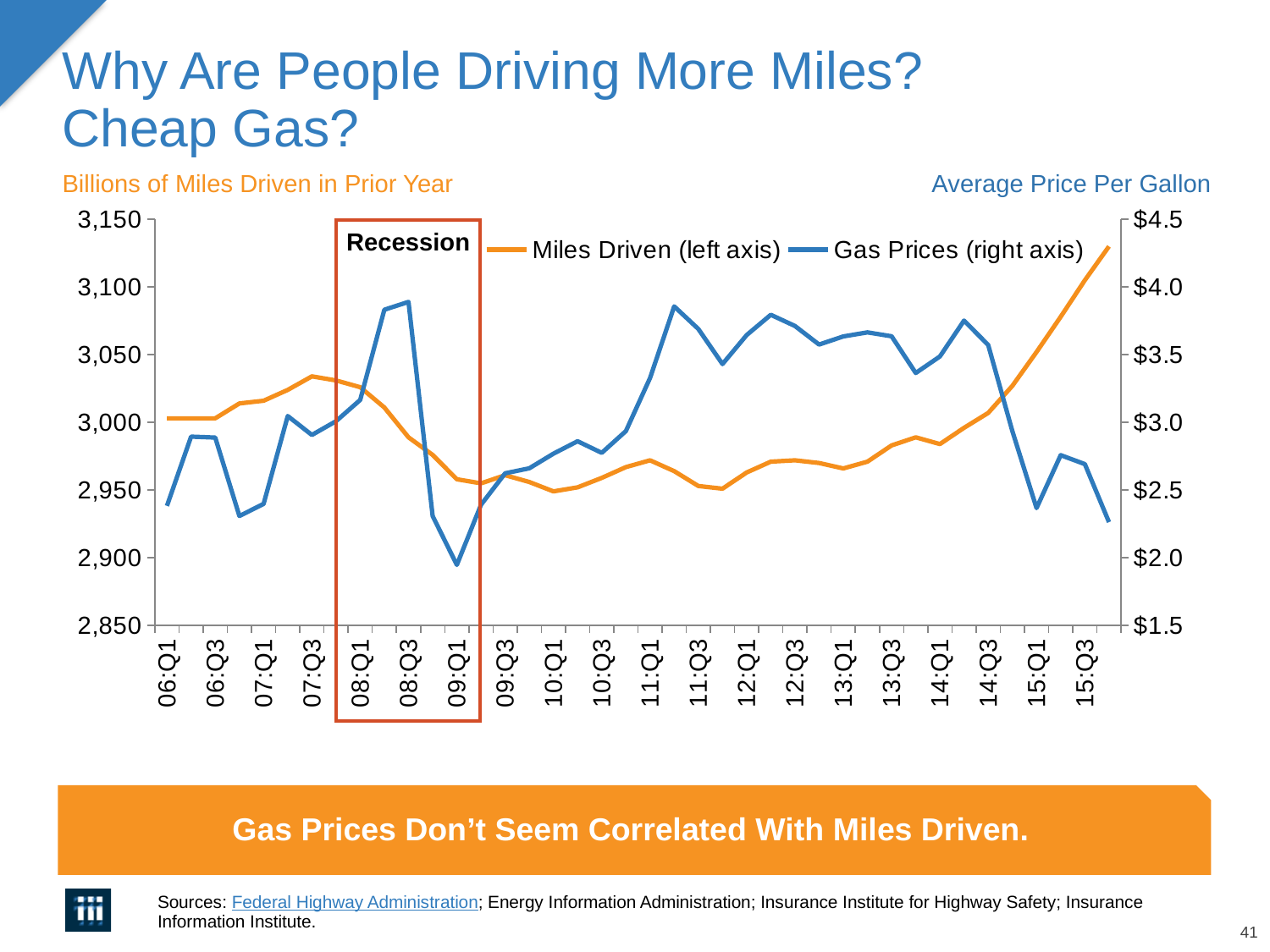
At which quarter does the Gas Prices series reach its lowest point? 09:Q1 Does the Miles Driven series rise or fall from 14:Q1 to 15:Q3? Rise Which series is plotted against the right axis? Gas Prices Is the Miles Driven value at 09:Q1 greater or less than 3,000? less Is the Gas Prices value at 09:Q1 greater or less than $2.5? less Does the Gas Prices series rise or fall from 14:Q3 to 15:Q1? Fall How many series does the chart's legend list? 2 What kind of chart is shown on the slide? Line chart Is the Gas Prices value at 08:Q3 greater or less than $3.5? greater What period is marked by the red box on the chart? Recession Which is larger, the Miles Driven value at 07:Q3 or at 10:Q1? 07:Q3